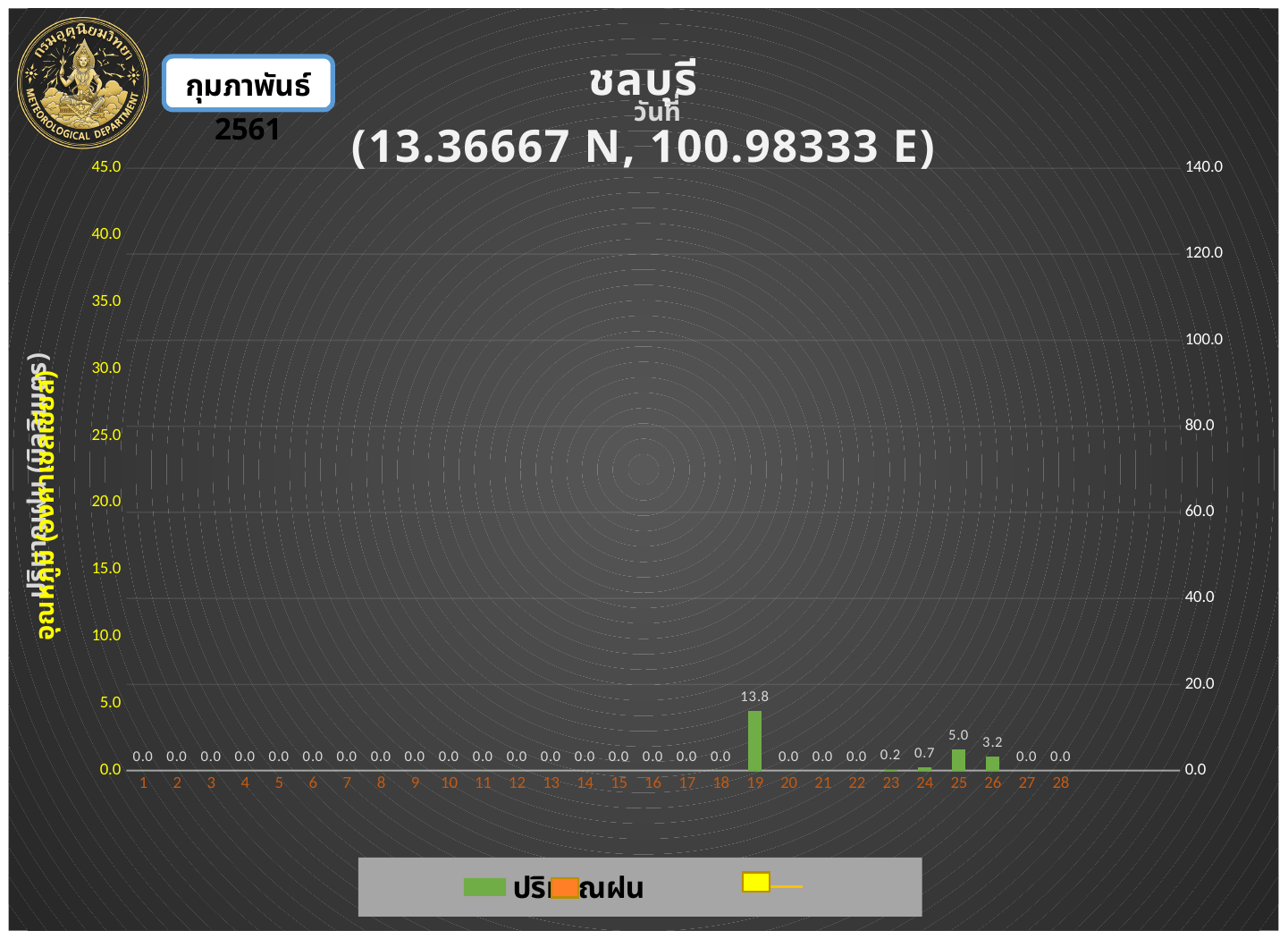
What is the value shown for day 23? 0.2 What is the value shown for day 24? 0.7 What is the difference between the values for day 19 and day 25? 8.8 What kind of chart is shown on the slide? bar chart What is the value shown for day 19? 13.8 What is the value shown for day 25? 5.0 Which day has the highest value? 19 Which is larger, the value for day 25 or the value for day 26? day 25 What is the value shown for day 26? 3.2 How many days are shown on the x axis? 28 What is the difference between the values for day 25 and day 26? 1.8